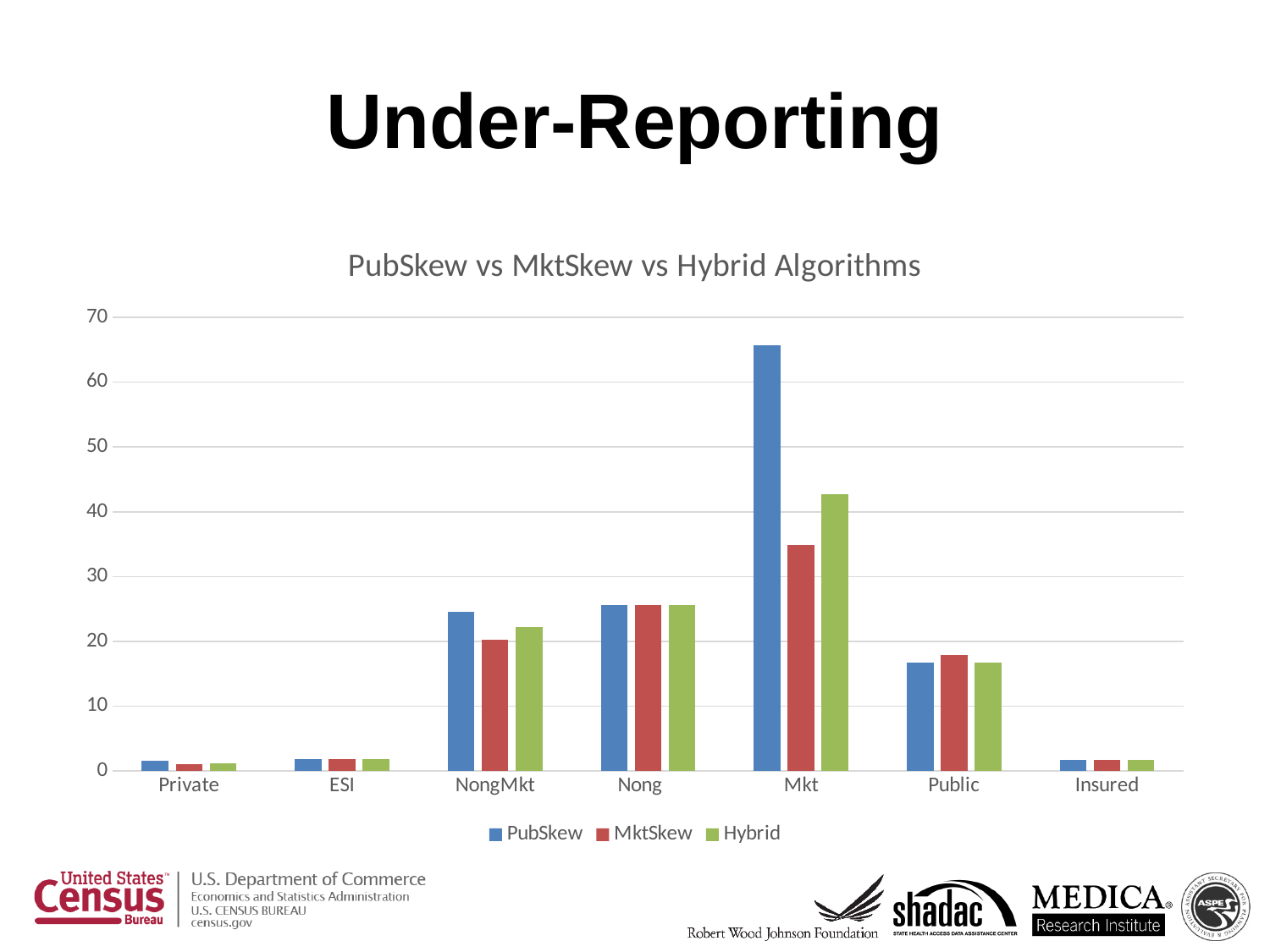
Which category has the highest Hybrid value? Mkt Is the Hybrid value for Mkt greater or less than 40? greater What is the title of the chart? PubSkew vs MktSkew vs Hybrid Algorithms What kind of chart is shown on the slide? Bar chart Is the PubSkew value for Public greater or less than 20? less Is the PubSkew value for Mkt greater or less than 60? greater For NongMkt, which is larger: the PubSkew value or the MktSkew value? PubSkew How many series does the legend list? 3 Which category has the highest PubSkew value? Mkt How many categories are shown on the x axis? 7 Which colour represents the PubSkew series in the legend? Blue